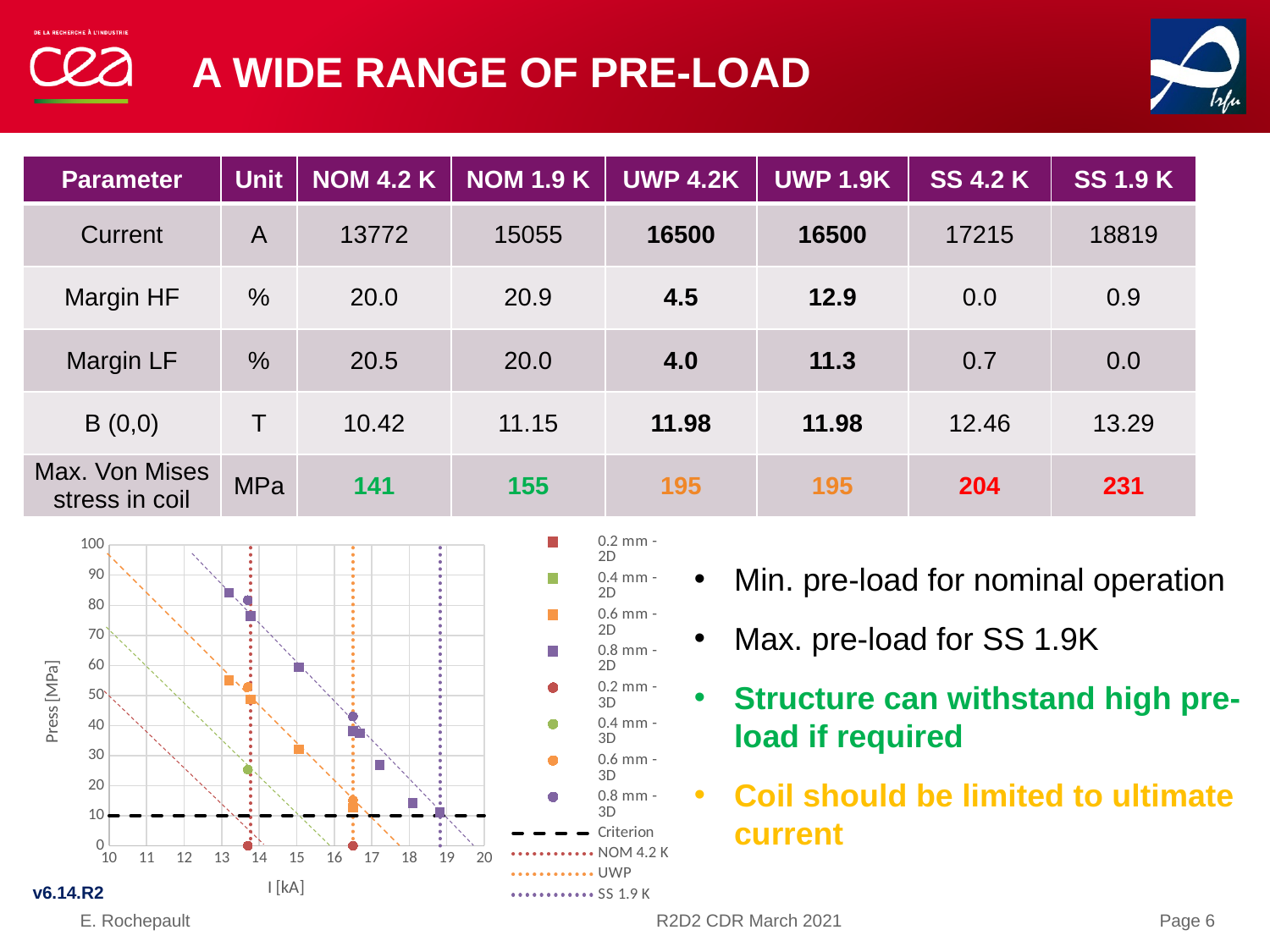
How many vertical dotted lines marking operating currents are drawn on the chart? 3 Which vertical dotted line is at a higher current, SS 1.9 K or NOM 4.2 K? SS 1.9 K Is the vertical dotted SS 1.9 K line at a current greater or less than 18 kA? greater What is the maximum value shown on the y axis of the chart? 100 What kind of chart is shown at the bottom left of the slide? scatter chart How many entries does the legend of the chart list? 12 Is the vertical dotted NOM 4.2 K line at a current greater or less than 15 kA? less Do the plotted points for the 0.8 mm - 2D series rise or fall as current increases? fall At what Press [MPa] value is the horizontal dashed Criterion line drawn? 10 Is the vertical dotted UWP line at a current greater or less than 16 kA? greater What is the label of the y axis of the chart? Press [MPa] What is the label of the x axis of the chart? I [kA]